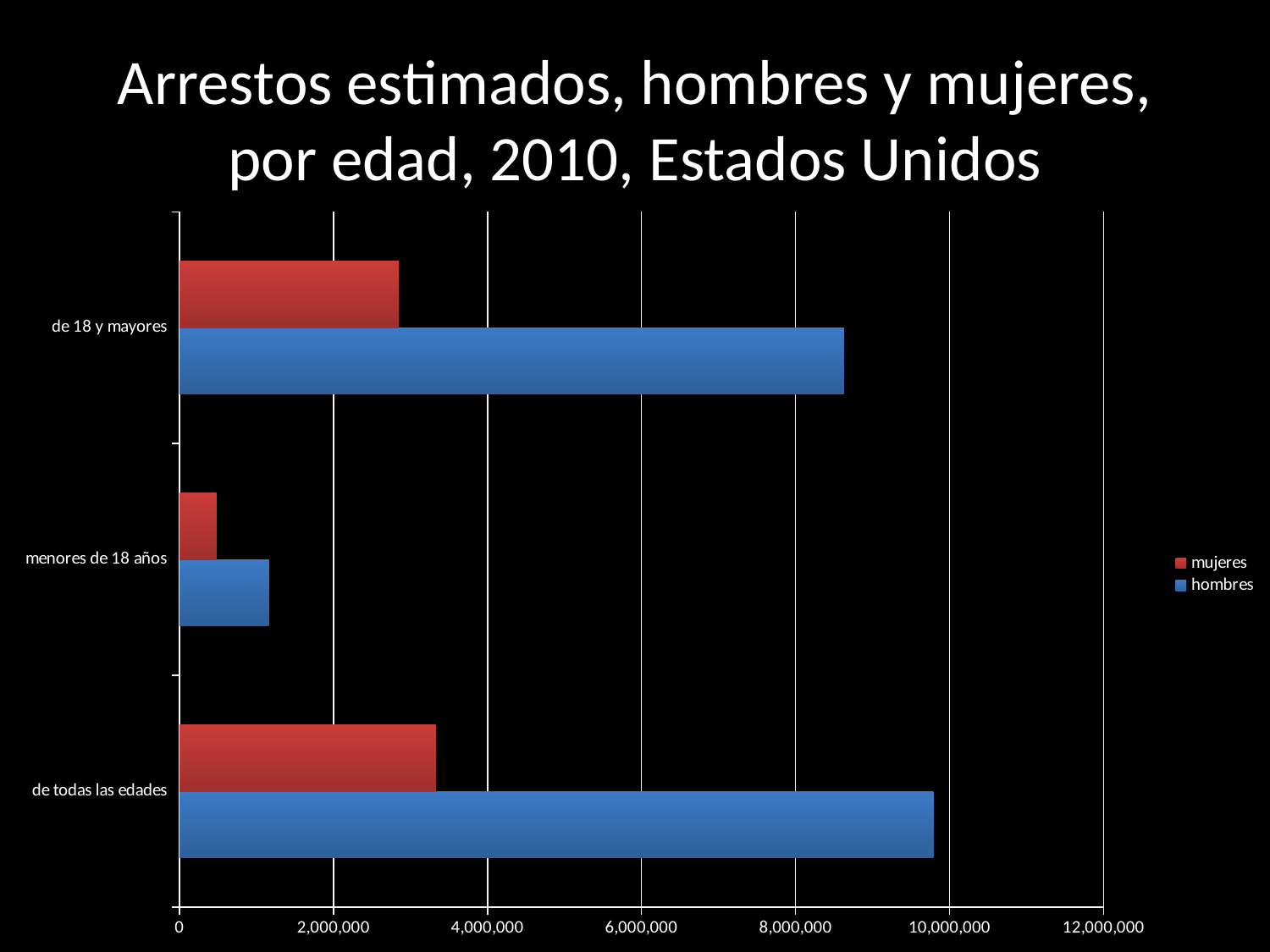
Which category has the lowest value for mujeres? menores de 18 años How many age categories are shown on the chart? 3 Is the value for mujeres in 'de 18 y mayores' greater or less than 4,000,000? less Is the value for hombres in 'menores de 18 años' greater or less than 2,000,000? less What is the title of the chart? Arrestos estimados, hombres y mujeres, por edad, 2010, Estados Unidos What kind of chart is shown on the slide? bar chart Is the value for hombres in 'de todas las edades' greater or less than 8,000,000? greater Which category has the highest value for hombres? de todas las edades For 'de 18 y mayores', which is larger: hombres or mujeres? hombres How many series does the legend list? 2 Which colour represents the 'mujeres' series? red